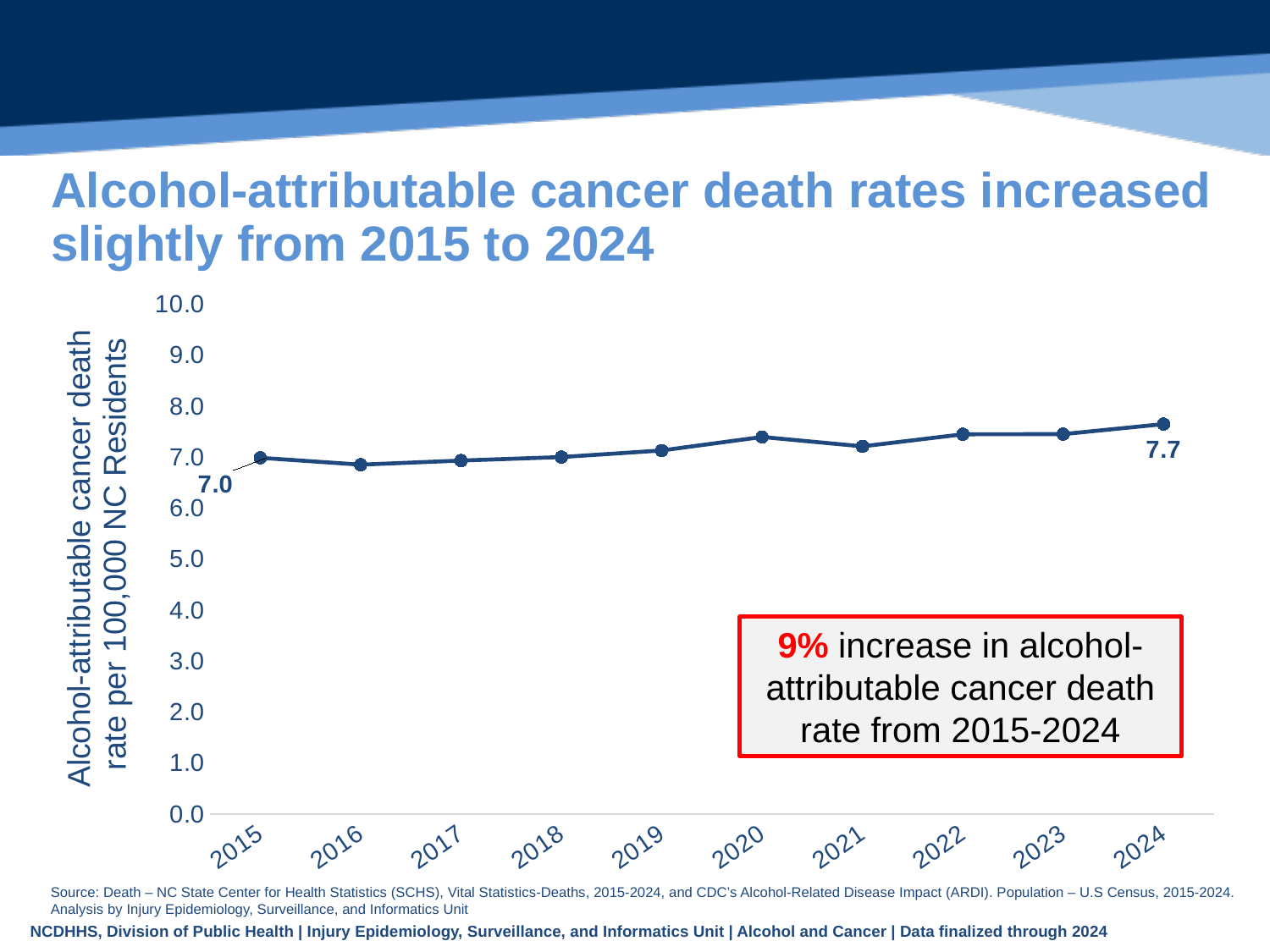
Which year has the highest alcohol-attributable cancer death rate? 2024 What is the alcohol-attributable cancer death rate for 2015? 7.0 Which is larger, the death rate in 2016 or in 2020? 2020 Is the value for 2023 greater or less than 8.0? less What is the alcohol-attributable cancer death rate for 2024? 7.7 What percentage increase in the alcohol-attributable cancer death rate from 2015-2024 is highlighted in the box on the chart? 9% What kind of chart is shown on the slide? Line chart By how much did the alcohol-attributable cancer death rate change from 2015 to 2024? 0.7 Is the value for 2020 greater or less than 7.0? greater Do the alcohol-attributable cancer death rates generally rise or fall from 2015 to 2024? Rise Which is larger, the death rate in 2015 or in 2024? 2024 How many years are plotted on the chart? 10